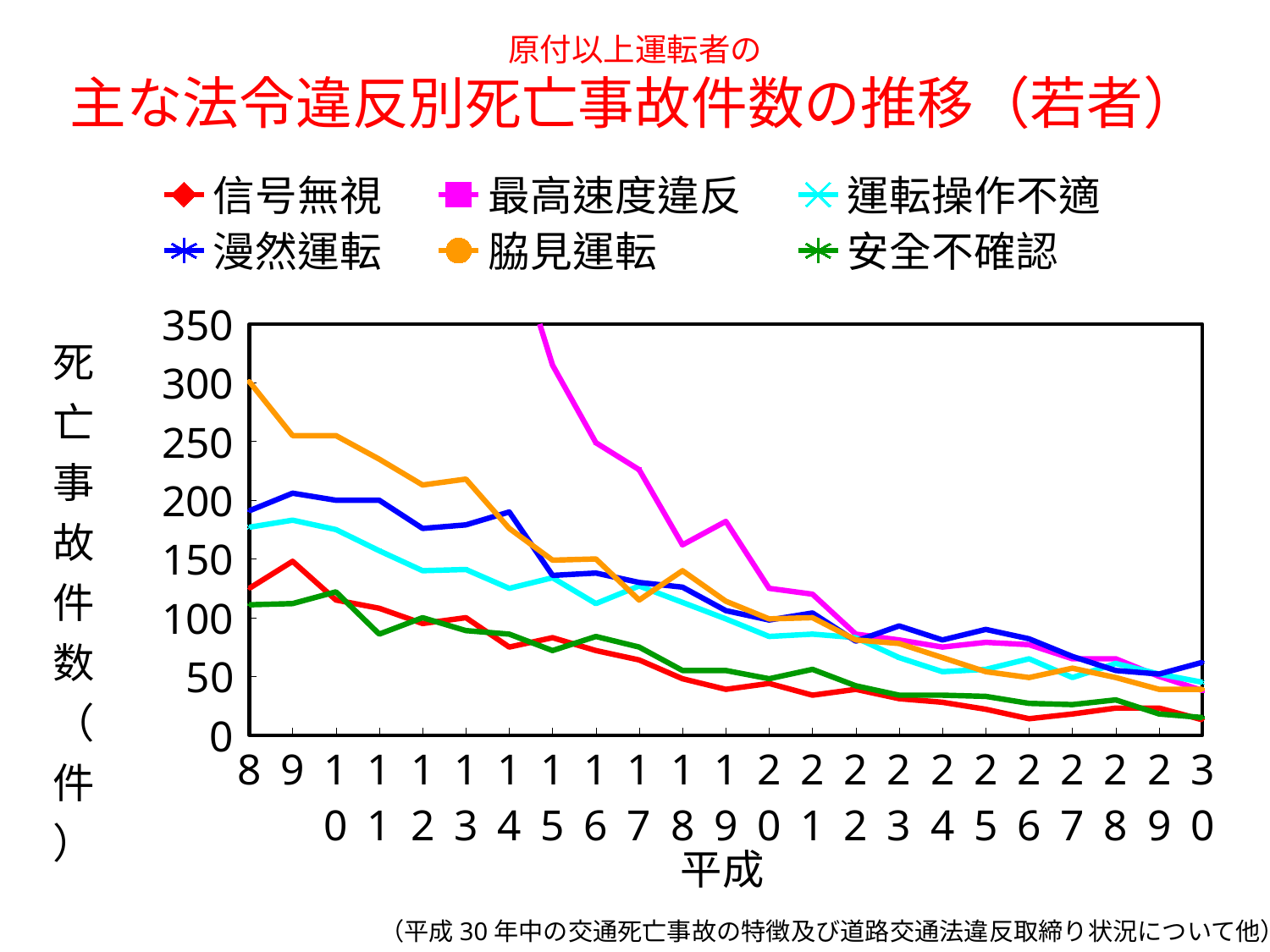
Which series has the highest value in 平成30? 漫然運転 Is the value for 信号無視 in 平成8 greater or less than 100? greater How many series does the legend list? 6 Does the 脇見運転 line generally rise or fall from 平成8 to 平成30? fall Is the value for 安全不確認 in 平成30 greater or less than 50? less Is the value for 最高速度違反 in 平成16 greater or less than 200? greater What kind of chart is shown on the slide? line chart In 平成30, which is larger: 漫然運転 or 安全不確認? 漫然運転 In 平成8, which is larger: 脇見運転 or 漫然運転? 脇見運転 What is the highest value shown on the y axis? 350 How many years (points) are shown along the x axis? 23